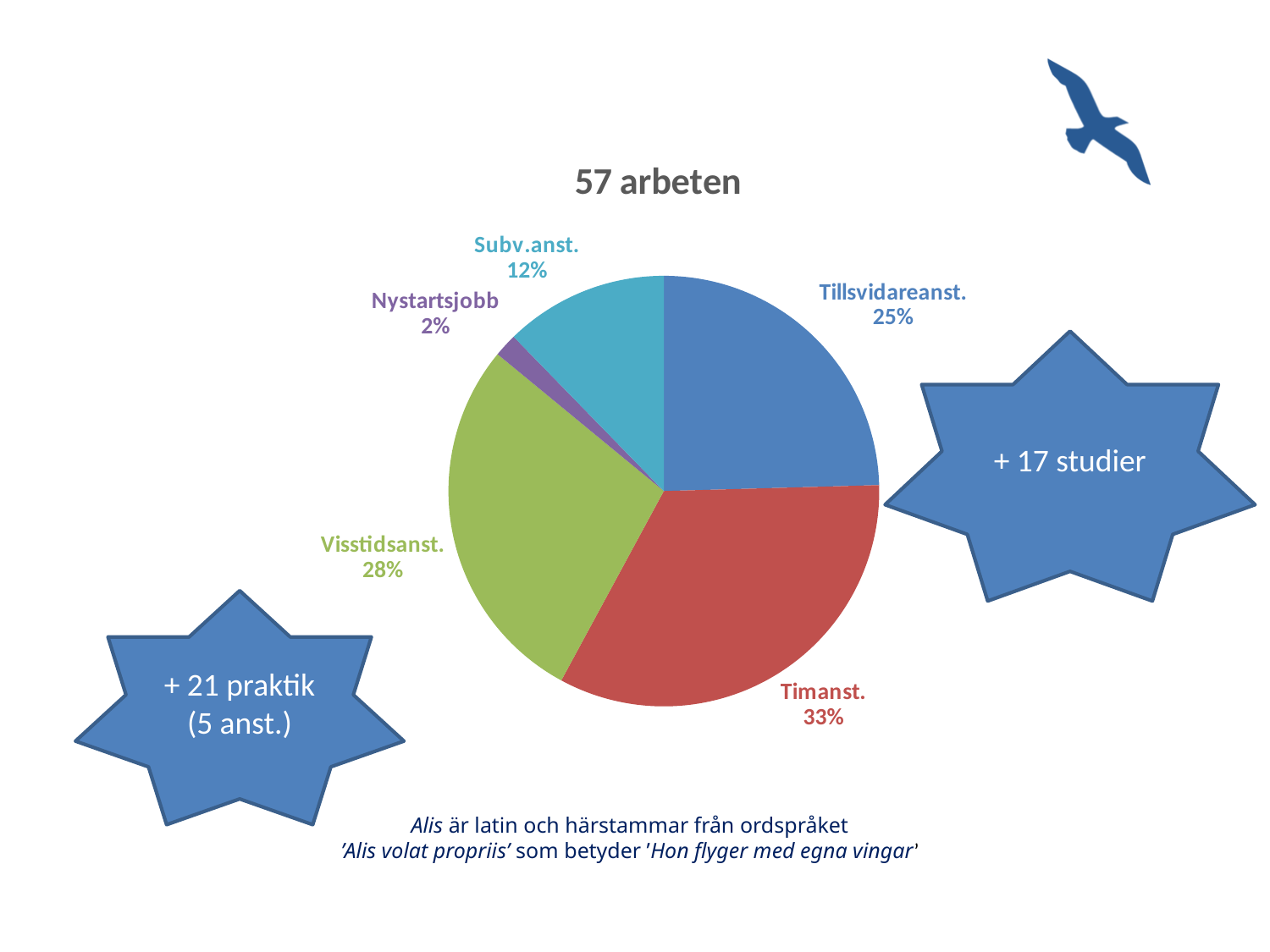
Which category has the largest slice of the pie? Timanst. What is the title of the chart? 57 arbeten How many categories are shown in the pie chart? 5 What is the difference in percentage points between Timanst. and Tillsvidareanst.? 8 Which category has the smallest slice of the pie? Nystartsjobb What share of the pie does Nystartsjobb represent? 2% Which is larger, the share for Visstidsanst. or the share for Subv.anst.? Visstidsanst. What type of chart is shown on the slide? pie chart What share of the pie does Visstidsanst. represent? 28% What share of the pie does Tillsvidareanst. represent? 25%